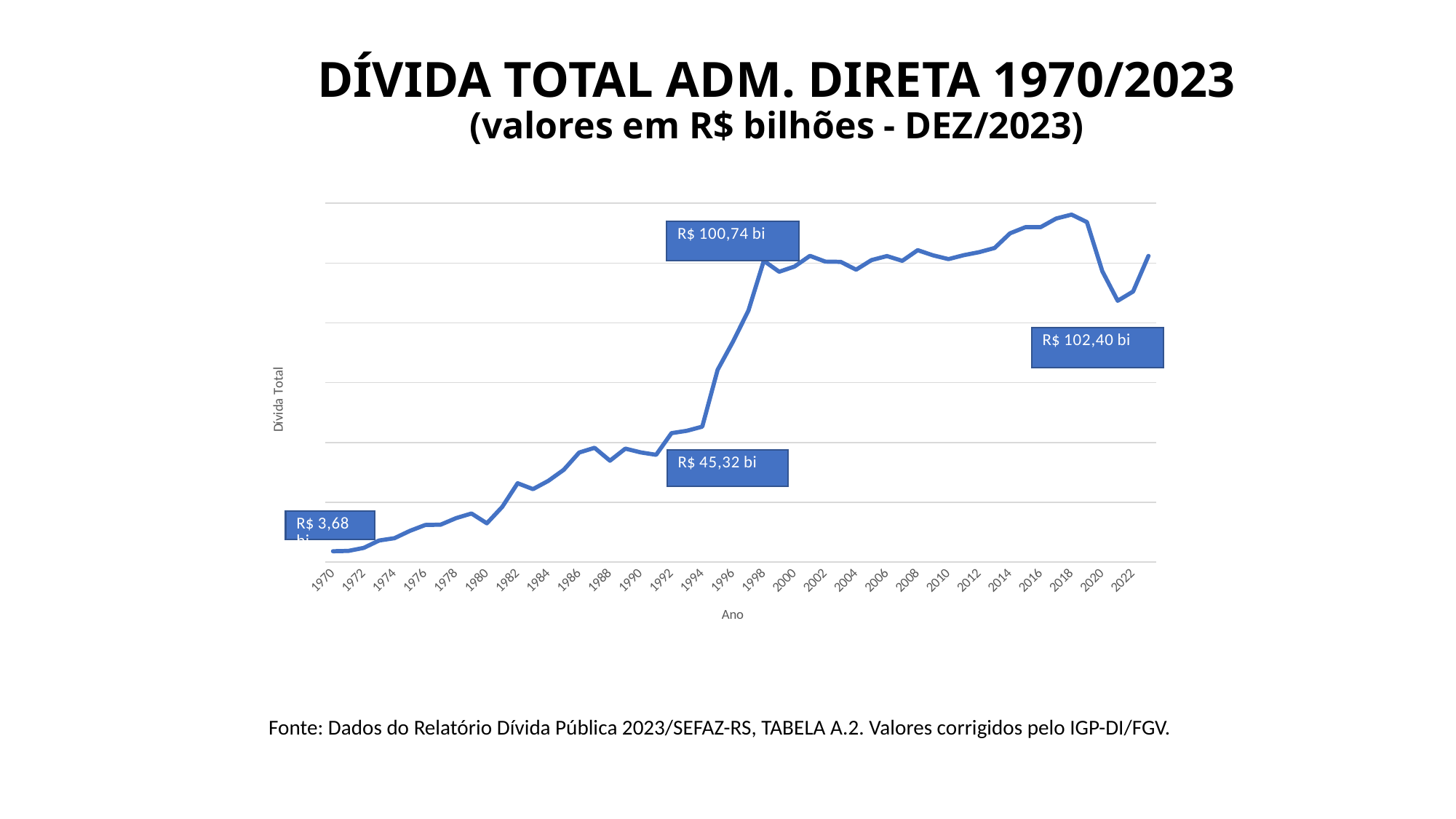
What is the title of the chart on the slide? DÍVIDA TOTAL ADM. DIRETA 1970/2023 (valores em R$ bilhões - DEZ/2023) What is the first data label shown on the chart, at the start of the line near 1970? R$ 3,68 bi What is the data label shown near 1992 on the chart? R$ 45,32 bi What kind of chart is shown on the slide? line chart What is the last data label shown on the chart, at the right end of the line? R$ 102,40 bi Which of the printed data labels shows the lowest value? R$ 3,68 bi What is the difference between the labeled values R$ 100,74 bi and R$ 45,32 bi? R$ 55,42 bi What is the label of the x axis of the chart? Ano What is the data label shown near 1998 on the chart? R$ 100,74 bi Which of the printed data labels shows the highest value? R$ 102,40 bi Overall, does the debt rise or fall from 1970 to 2023 along the x axis? rise How many data labels are printed on the chart? 4